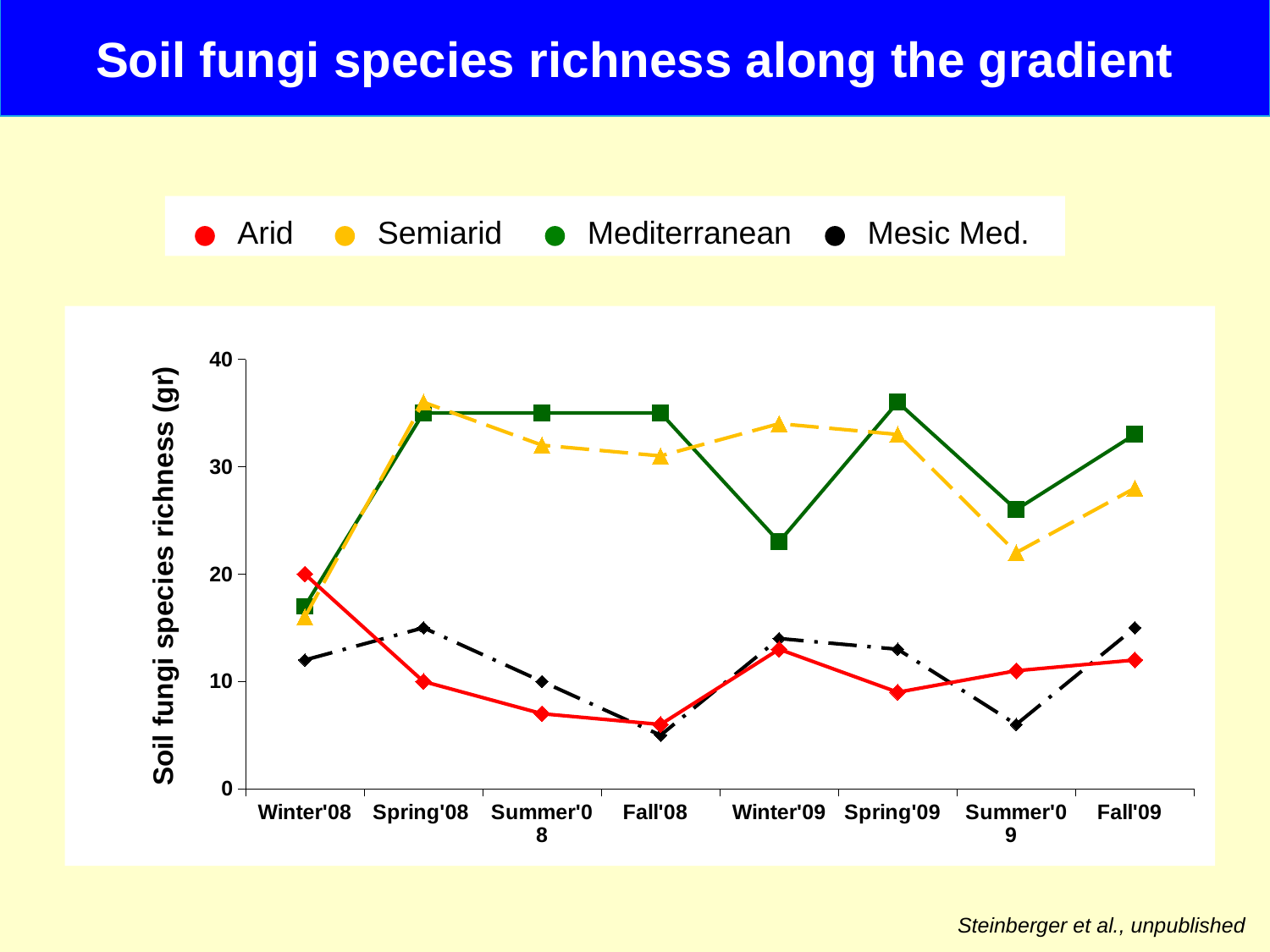
What is the value for Arid at Spring'08? 10 What is the value for Arid at Winter'08? 20 How many series does the legend list? 4 Which series has the highest value at Winter'09? Semiarid Is the value for Semiarid at Spring'08 greater or less than 30? greater Does the Arid series rise or fall from Winter'08 to Fall'08? fall Is the value for Arid at Fall'08 greater or less than 10? less What is the label on the y axis? Soil fungi species richness (gr) At Summer'09, which is larger: Mediterranean or Semiarid? Mediterranean Is the value for Mediterranean at Winter'09 greater or less than 30? less How many time points are shown along the x axis? 8 What kind of chart is shown on the slide? line chart